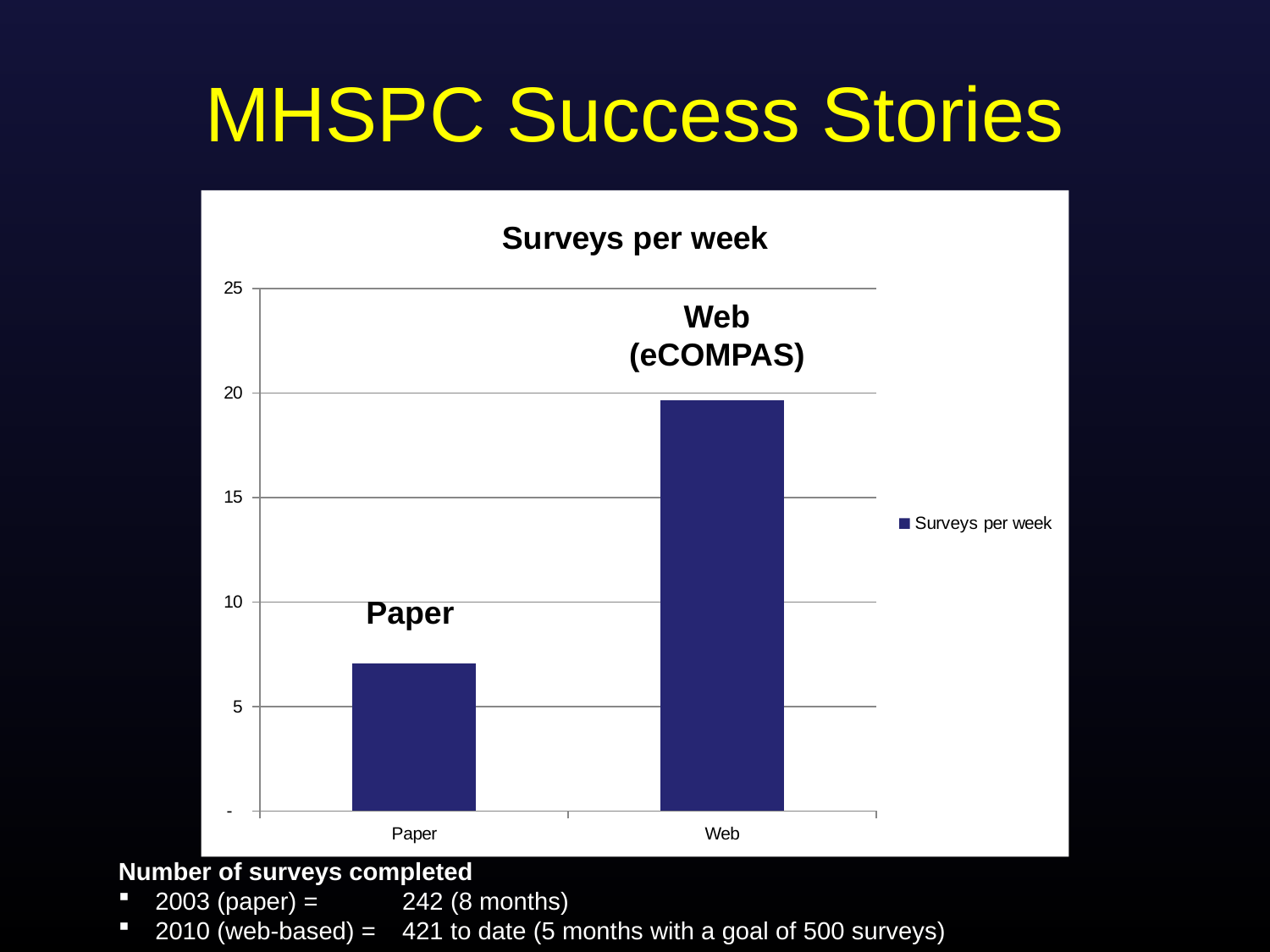
Is the value for Web greater or less than 15? greater Which has more surveys per week, Paper or Web? Web Is the value for Web greater or less than 25? less Is the value for Paper greater or less than 10? less What type of chart is shown on the slide? bar chart What is the title of the chart? Surveys per week How many series does the chart's legend list? 1 How many categories are plotted on the x axis of the chart? 2 Which category has the lowest surveys per week? Paper Which category has the highest surveys per week? Web What is the name of the series shown in the chart's legend? Surveys per week